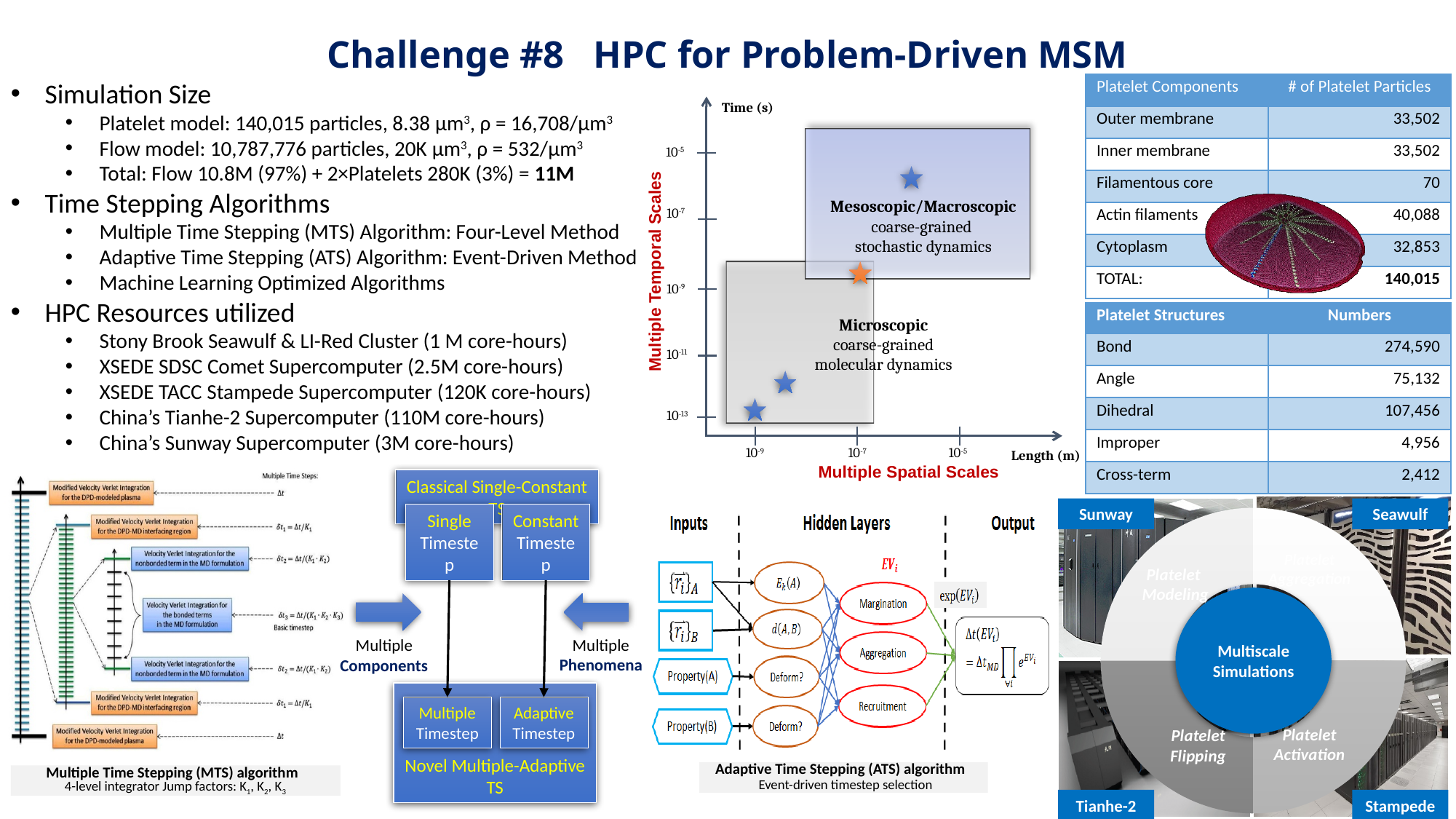
What kind of chart is the Time (s) versus Length (m) plot in the middle of the slide? scatter chart What is the label of the vertical axis of the Time versus Length chart? Time (s) On the Time versus Length chart, is the time value of the orange star greater or less than 10^-7 s? less On the Time versus Length chart, do the time values of the stars rise or fall as length increases? rise On the Time versus Length chart, is the time value of the star inside the Mesoscopic/Macroscopic region greater or less than 10^-7 s? greater On the Time versus Length chart, which has the larger time value: the orange star or the lowest blue star? the orange star How many labeled regions (shaded boxes) are shown on the Time versus Length chart? 2 On the Time versus Length chart, is the time value of the lowest blue star greater or less than 10^-11 s? less What is the label of the horizontal axis of the Time versus Length chart? Length (m) How many star markers are plotted on the Time versus Length chart? 4 On the Time versus Length chart, which labeled region contains the star with the largest time value? Mesoscopic/Macroscopic